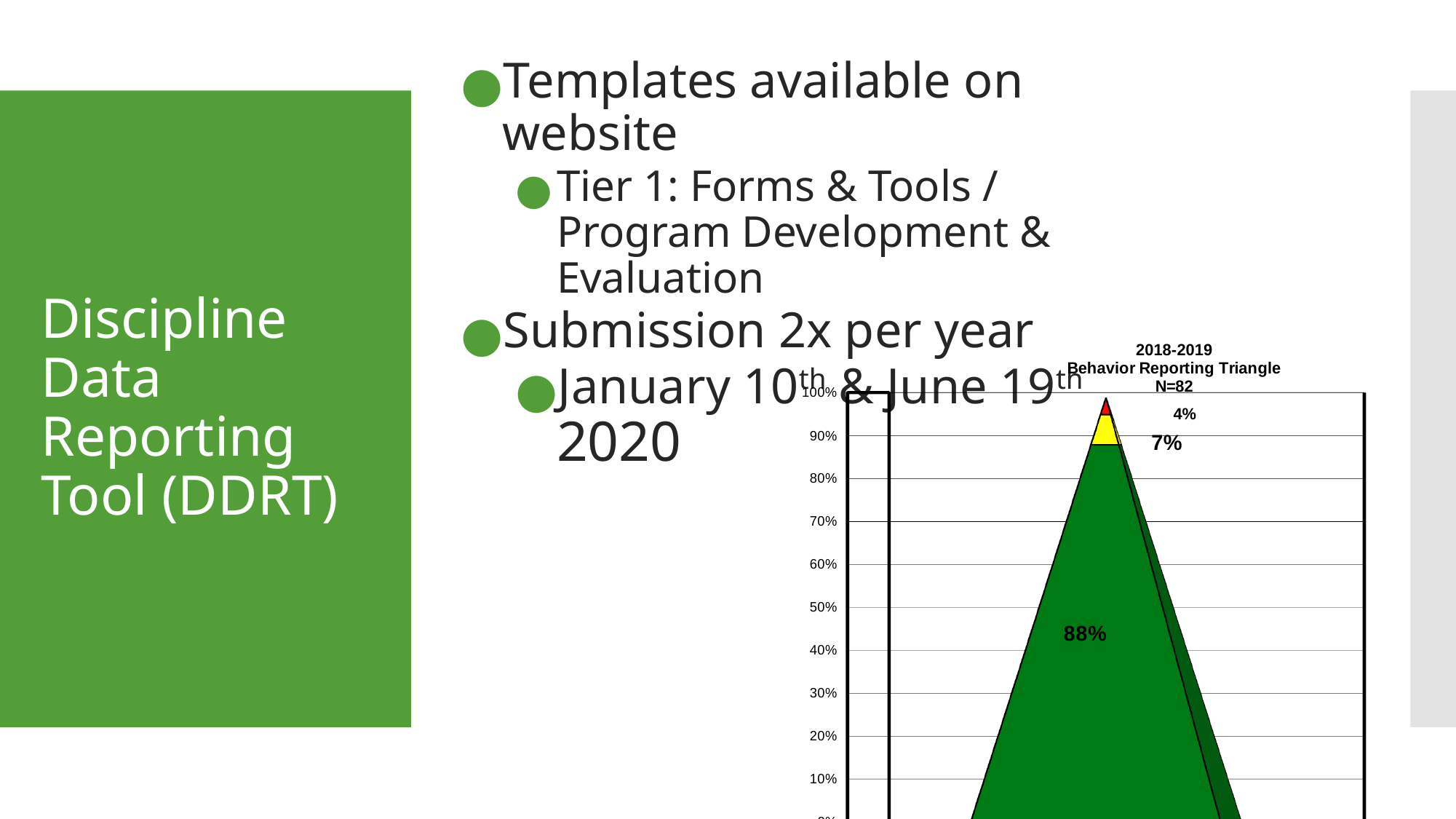
What is the highest value shown on the chart's vertical axis? 100% What percentage is shown for the red section at the top of the Behavior Reporting Triangle? 4% Which coloured section of the triangle has the smallest percentage? Red (4%) What is the difference in percentage points between the green section and the yellow section? 81 percentage points What percentage is shown for the yellow section of the Behavior Reporting Triangle? 7% Which school year does the Behavior Reporting Triangle cover? 2018-2019 What percentage is shown for the green section of the Behavior Reporting Triangle? 88% What is the N value stated in the chart title? N=82 Which is larger, the yellow section or the red section? Yellow section Which coloured section of the triangle has the largest percentage? Green (88%) What is the difference in percentage points between the yellow section and the red section? 3 percentage points How many coloured sections make up the Behavior Reporting Triangle? 3